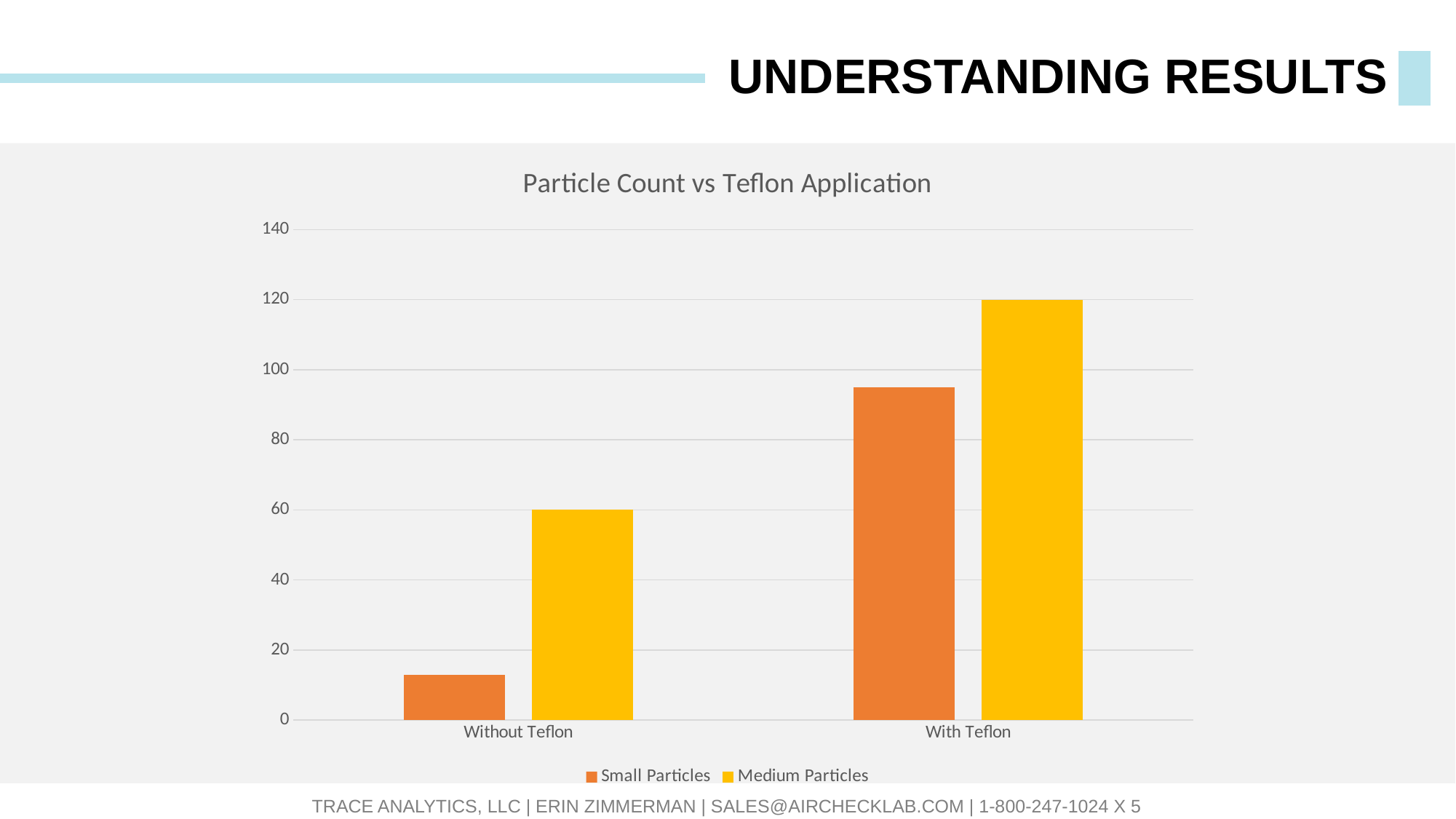
What is the difference between the Medium Particles values for With Teflon and Without Teflon? 60 Which series is shown in orange? Small Particles What is the Medium Particles value for Without Teflon? 60 What type of chart is shown on the slide? bar chart What is the title of the chart? Particle Count vs Teflon Application Is the Small Particles value for With Teflon greater or less than 80? greater Which category has the highest Medium Particles value? With Teflon How many series does the legend list? 2 What is the Medium Particles value for With Teflon? 120 Which is larger for With Teflon, Small Particles or Medium Particles? Medium Particles Is the Small Particles value for Without Teflon greater or less than 20? less How many categories are shown on the x axis? 2